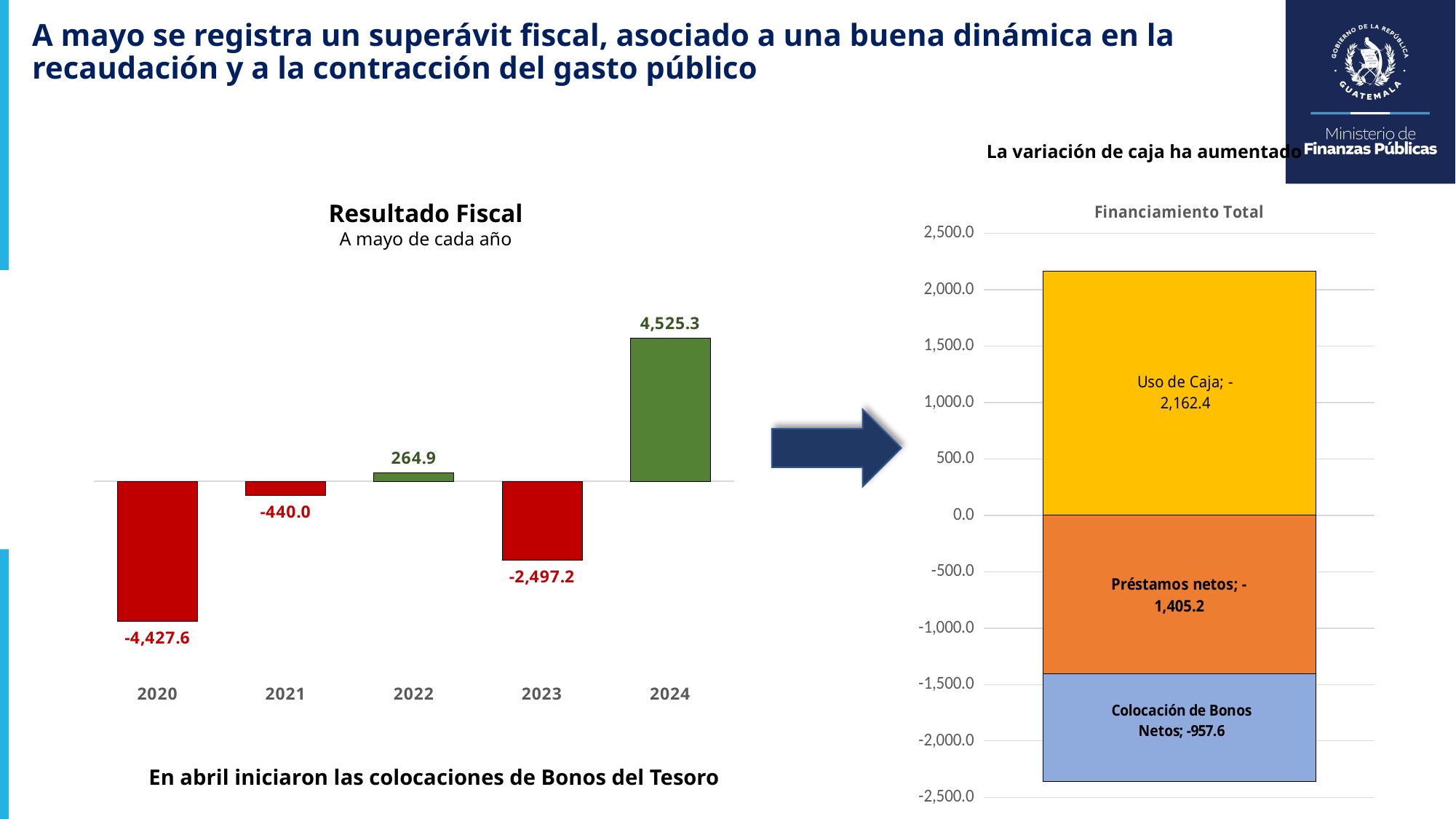
In the Resultado Fiscal chart, what is the value for 2024? 4,525.3 What kind of chart is the Resultado Fiscal chart? Bar chart In the Resultado Fiscal chart, which year has the lowest value? 2020 In the Resultado Fiscal chart, which year has the highest value? 2024 In the Financiamiento Total chart, what value is labelled for Préstamos netos? -1,405.2 In the Financiamiento Total chart, what colour is the Uso de Caja segment? Yellow In the Resultado Fiscal chart, what is the value for 2023? -2,497.2 In the Resultado Fiscal chart, what is the value for 2020? -4,427.6 In the Financiamiento Total chart, what value is labelled for Colocación de Bonos Netos? -957.6 In the Resultado Fiscal chart, which is larger, the value for 2021 or the value for 2022? 2022 In the Resultado Fiscal chart, what is the difference between the 2024 value and the 2022 value? 4,260.4 How many years are shown in the Resultado Fiscal chart? 5